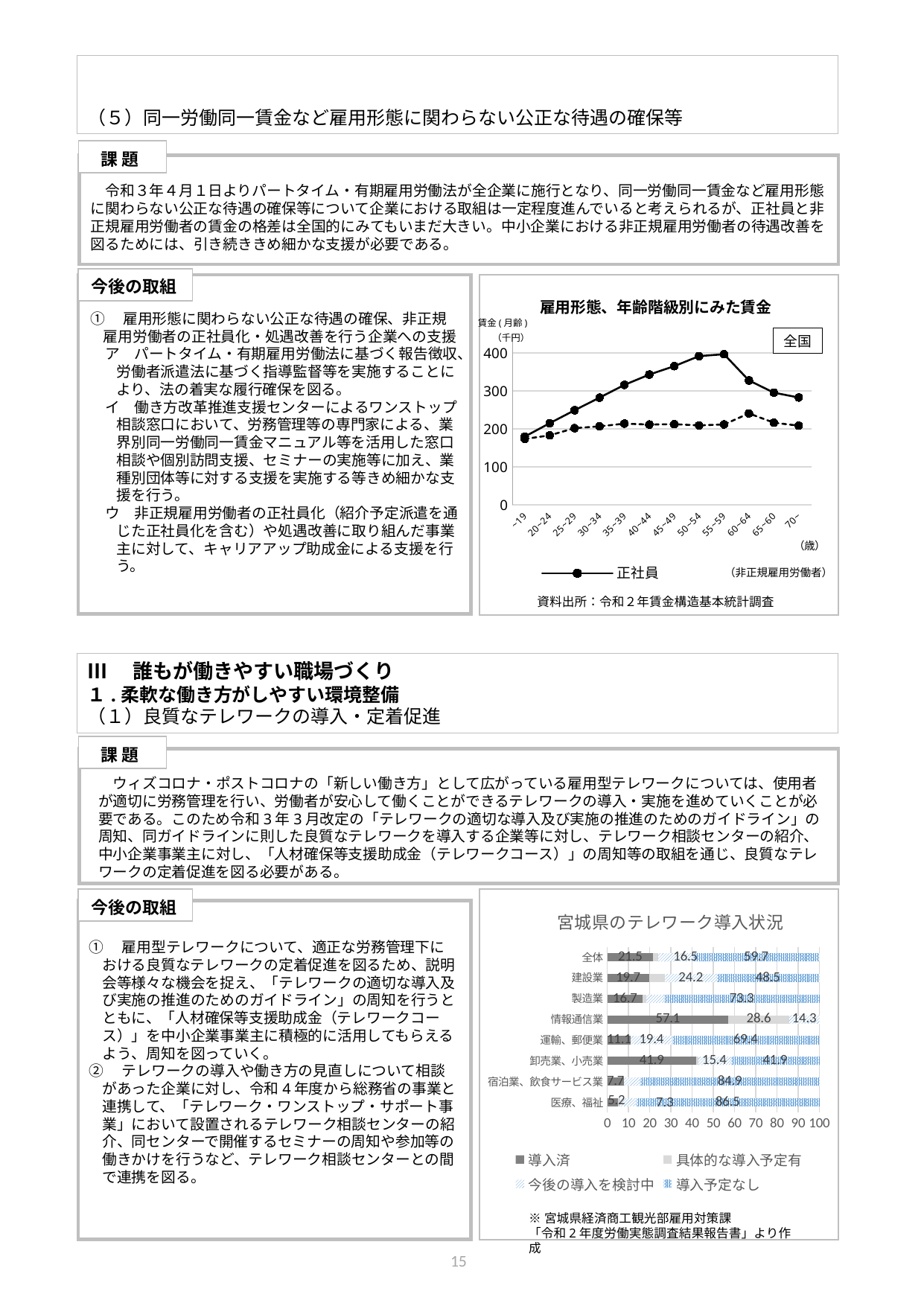
In the chart titled 宮城県のテレワーク導入状況, which category has the lowest 導入済 value? 医療、福祉 In the chart titled 宮城県のテレワーク導入状況, what is the difference between the 導入済 values for 情報通信業 and 医療、福祉? 51.9 In the chart titled 雇用形態、年齢階級別にみた賃金, is the 非正規雇用労働者 value for 45~49 greater or less than 300? less In the chart titled 宮城県のテレワーク導入状況, what is the 導入済 value for 情報通信業? 57.1 In the chart titled 宮城県のテレワーク導入状況, how many industry categories are shown? 8 In the chart titled 雇用形態、年齢階級別にみた賃金, what kind of chart is it? line chart In the chart titled 宮城県のテレワーク導入状況, which has the larger 導入済 value, 建設業 or 製造業? 建設業 In the chart titled 雇用形態、年齢階級別にみた賃金, how many age groups are shown on the x axis? 12 In the chart titled 雇用形態、年齢階級別にみた賃金, does the 正社員 line rise or fall from ~19 to 55~59? rise In the chart titled 宮城県のテレワーク導入状況, how many series does the legend list? 4 In the chart titled 雇用形態、年齢階級別にみた賃金, is the 正社員 value for 55~59 greater or less than 300? greater In the chart titled 雇用形態、年齢階級別にみた賃金, which age group has the highest wage for 正社員? 55~59